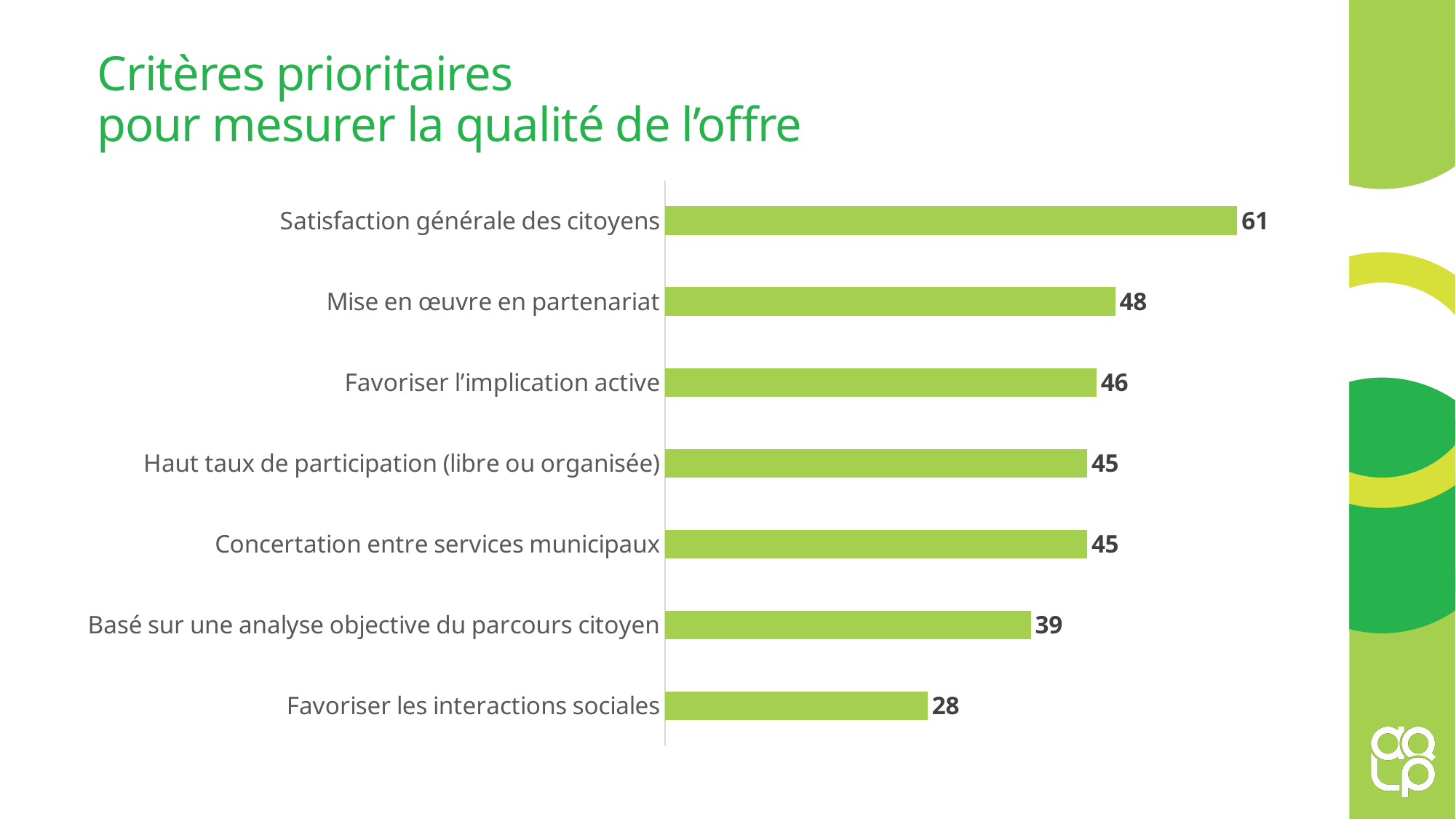
Which category has the lowest value? Favoriser les interactions sociales What is the value for "Basé sur une analyse objective du parcours citoyen"? 39 How many categories are shown in the chart? 7 What is the value for "Mise en œuvre en partenariat"? 48 Which is larger: "Mise en œuvre en partenariat" or "Basé sur une analyse objective du parcours citoyen"? Mise en œuvre en partenariat Which category has the highest value? Satisfaction générale des citoyens What is the difference between "Mise en œuvre en partenariat" and "Favoriser l'implication active"? 2 What is the difference between "Satisfaction générale des citoyens" and "Favoriser les interactions sociales"? 33 What is the title of the slide? Critères prioritaires pour mesurer la qualité de l'offre What is the value for "Satisfaction générale des citoyens"? 61 What kind of chart is shown on the slide? Bar chart What is the value for "Favoriser les interactions sociales"? 28